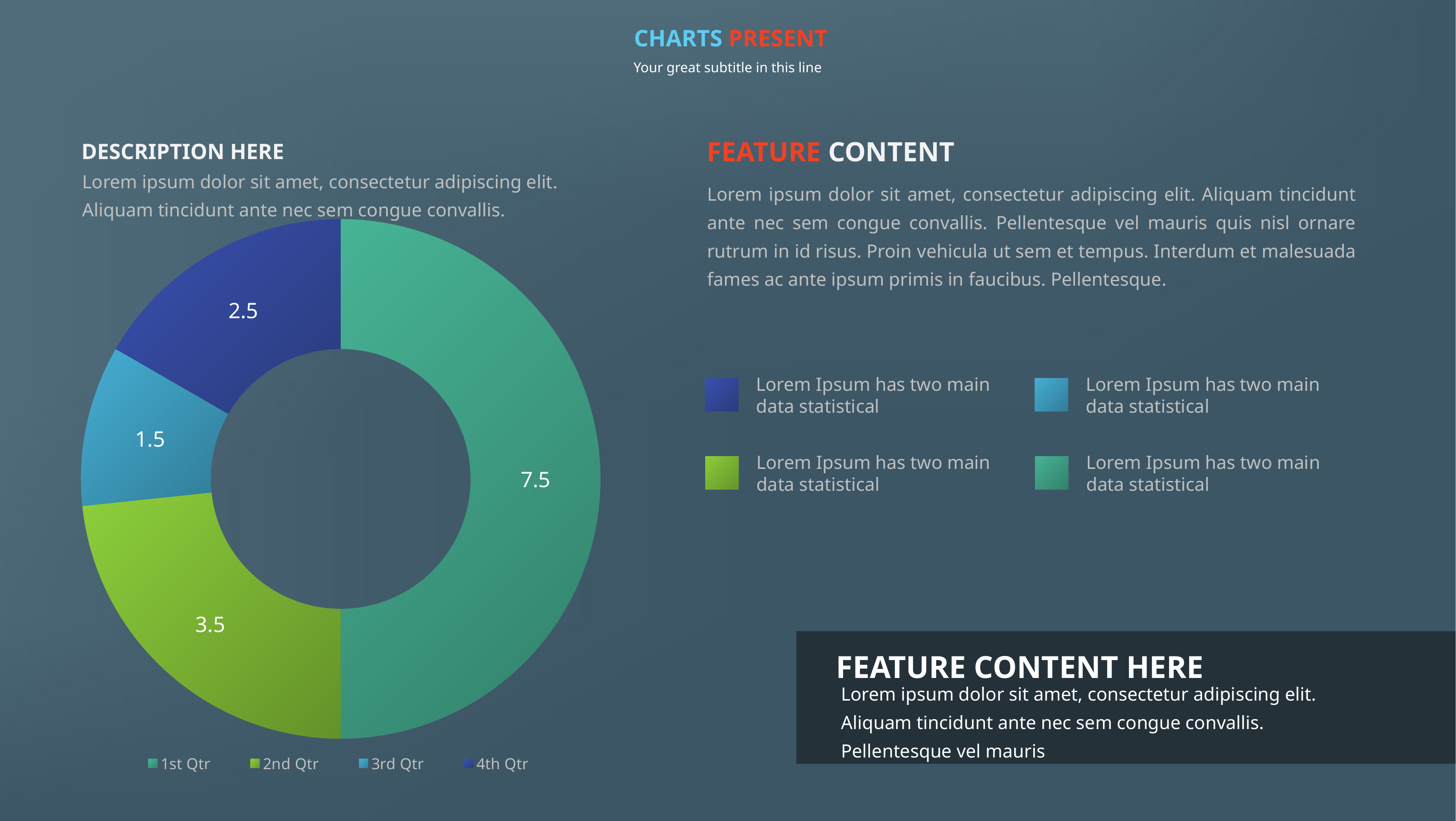
Which quarter has the smallest value in the doughnut chart? 3rd Qtr What is the value for 2nd Qtr in the doughnut chart? 3.5 What is the difference between the values for 1st Qtr and 2nd Qtr? 4 What kind of chart is shown on the slide? Doughnut chart What is the value for 3rd Qtr in the doughnut chart? 1.5 What colour is the 2nd Qtr slice in the doughnut chart? Green What share of the total does the 1st Qtr slice represent? 50% Which is larger, the value for 4th Qtr or the value for 3rd Qtr? 4th Qtr What is the value for 1st Qtr in the doughnut chart? 7.5 What is the value for 4th Qtr in the doughnut chart? 2.5 How many slices does the doughnut chart have? 4 Which quarter has the largest value in the doughnut chart? 1st Qtr